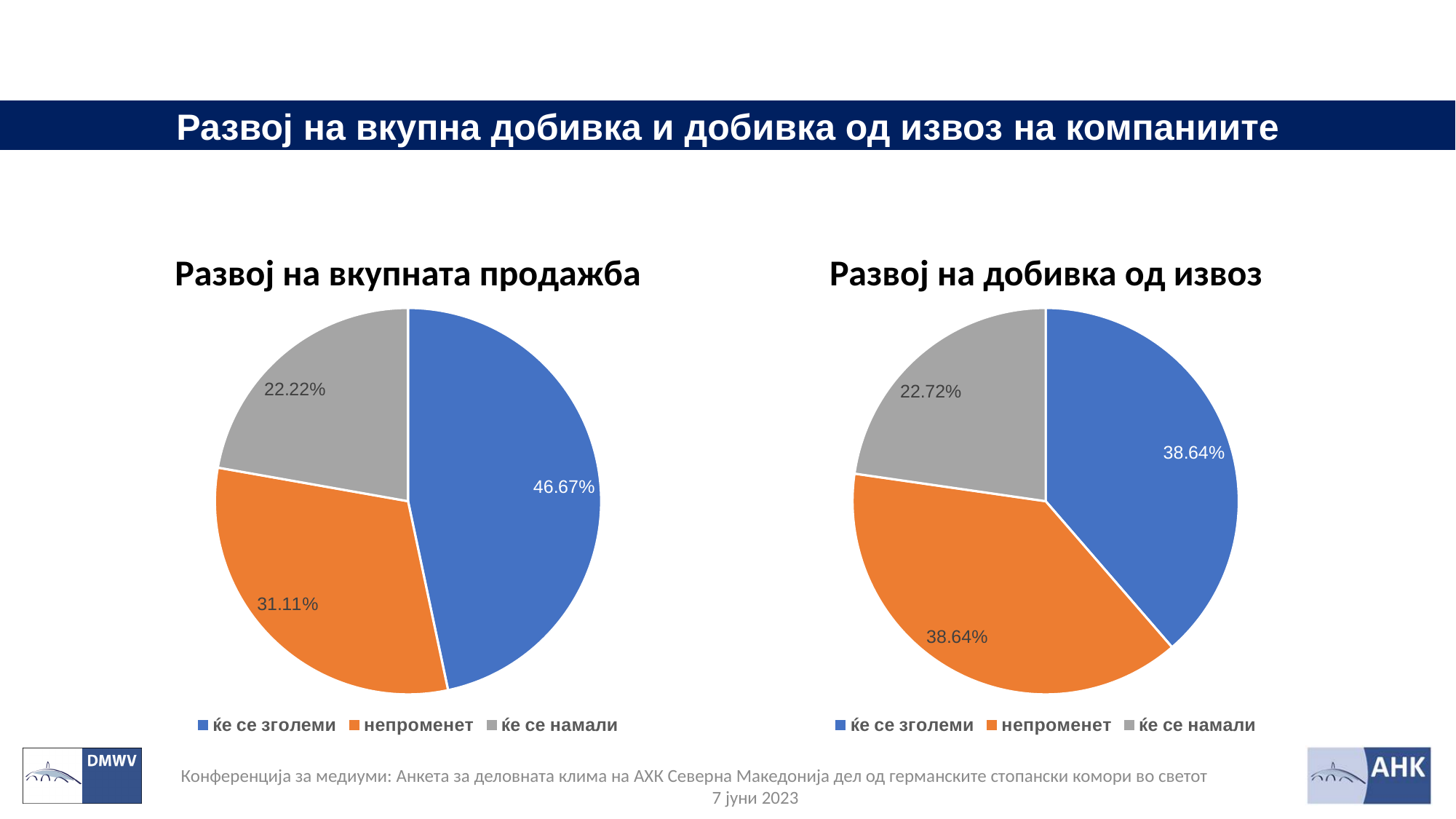
In the chart titled "Развој на добивка од извоз", which category has the smallest slice? ќе се намали In the chart titled "Развој на добивка од извоз", what share is labelled for "ќе се зголеми"? 38.64% In the chart titled "Развој на вкупната продажба", which category has the largest slice? ќе се зголеми In the chart titled "Развој на добивка од извоз", what share is labelled for "ќе се намали"? 22.72% How many slices does the chart titled "Развој на вкупната продажба" have? 3 In the chart titled "Развој на вкупната продажба", what share is labelled for "ќе се намали"? 22.22% In the chart titled "Развој на вкупната продажба", what share is labelled for "ќе се зголеми"? 46.67% In the chart titled "Развој на вкупната продажба", which colour represents "непроменет"? orange What kind of chart is the chart titled "Развој на добивка од извоз"? pie chart In the chart titled "Развој на добивка од извоз", which is larger: "непроменет" or "ќе се намали"? непроменет In the chart titled "Развој на вкупната продажба", what is the difference in percentage points between "ќе се зголеми" and "ќе се намали"? 24.45 In the chart titled "Развој на вкупната продажба", what share is labelled for "непроменет"? 31.11%